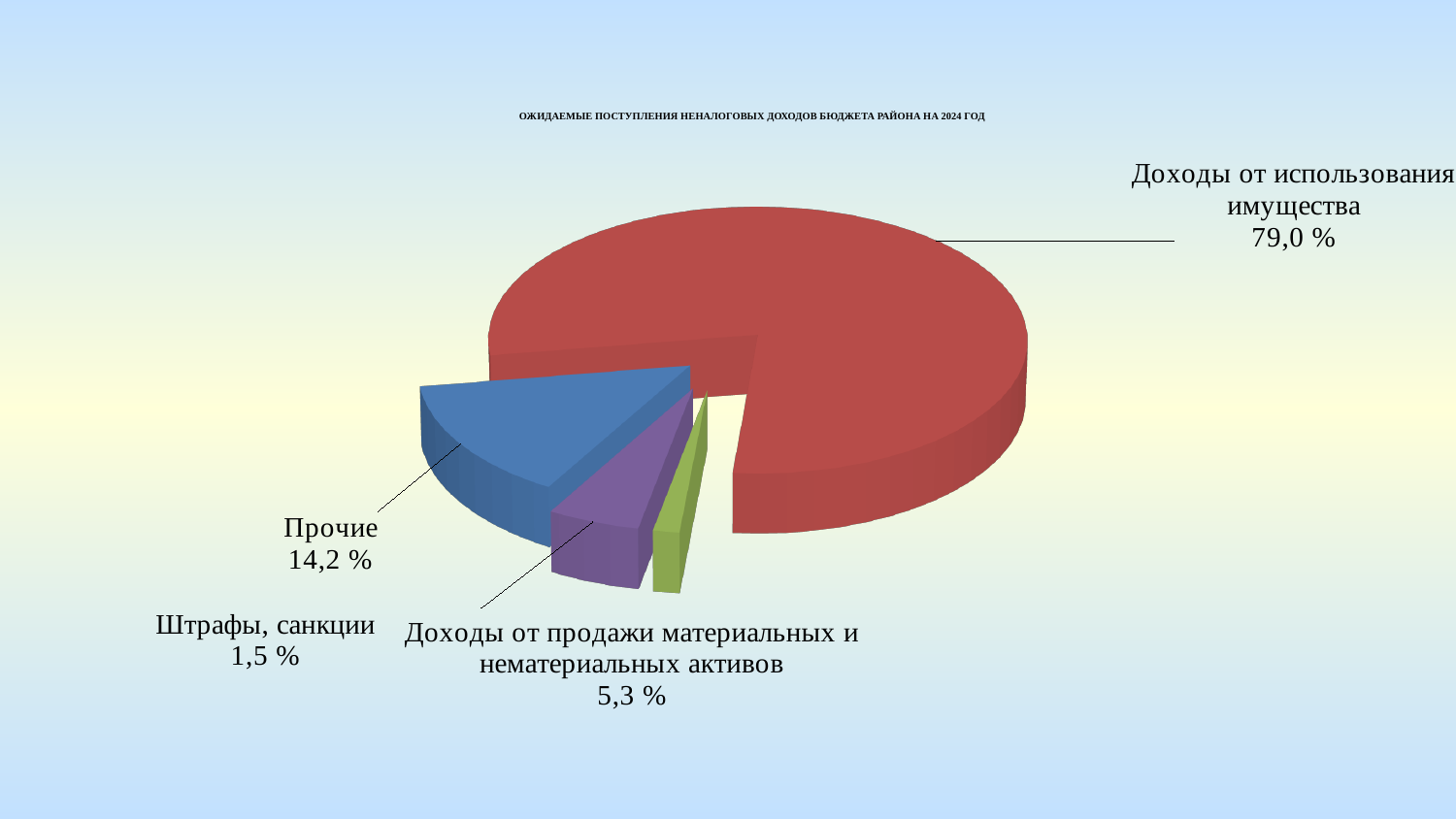
What share of the pie does "Доходы от использования имущества" represent? 79,0 % Which category has the largest slice of the pie? Доходы от использования имущества What is the title of the chart? ОЖИДАЕМЫЕ ПОСТУПЛЕНИЯ НЕНАЛОГОВЫХ ДОХОДОВ БЮДЖЕТА РАЙОНА НА 2024 ГОД What is the difference in percentage points between "Доходы от продажи материальных и нематериальных активов" and "Штрафы, санкции"? 3,8 What share of the pie does "Доходы от продажи материальных и нематериальных активов" represent? 5,3 % What share of the pie does "Штрафы, санкции" represent? 1,5 % Which category has the smallest slice of the pie? Штрафы, санкции What is the difference in percentage points between "Доходы от использования имущества" and "Прочие"? 64,8 What kind of chart is shown on the slide? Pie chart Which is larger: the share for "Прочие" or the share for "Доходы от продажи материальных и нематериальных активов"? Прочие How many slices does the pie chart have? 4